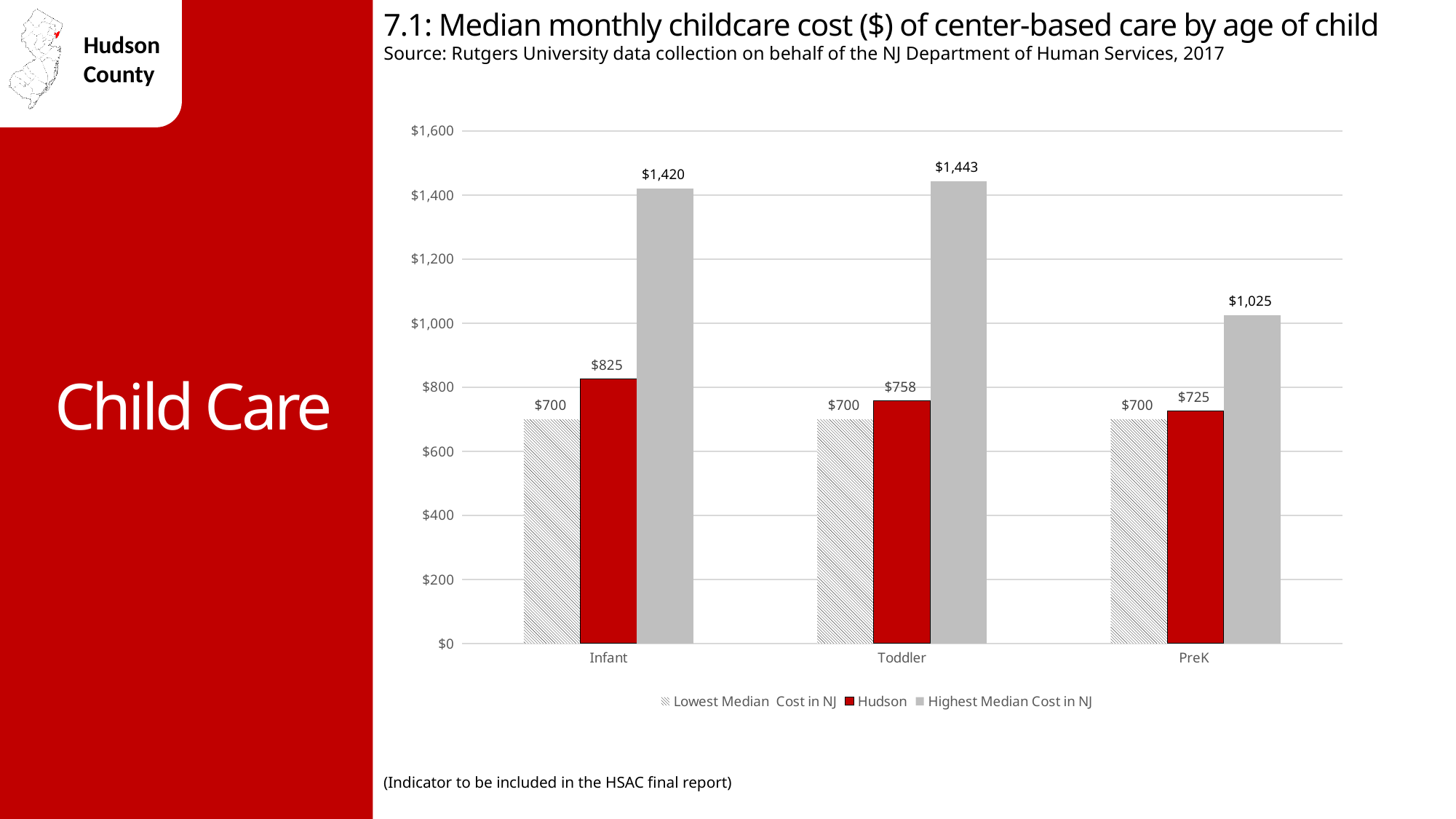
What is the difference between the Highest Median Cost in NJ and the Hudson cost for Infant care? $595 How many age groups are shown on the x axis? 3 Is the Highest Median Cost in NJ for PreK care greater or less than $1,200? less What colour are the Hudson bars? Red How many series does the legend list? 3 What is the Lowest Median Cost in NJ for PreK care? $700 Which age group has the highest Hudson median monthly cost? Infant What is the Highest Median Cost in NJ for Toddler care? $1,443 What kind of chart is shown on the slide? Bar chart Which age group has the lowest Highest Median Cost in NJ? PreK Which is larger: the Hudson cost for Toddler care or the Hudson cost for PreK care? Toddler What is the Hudson median monthly childcare cost for Infant care? $825